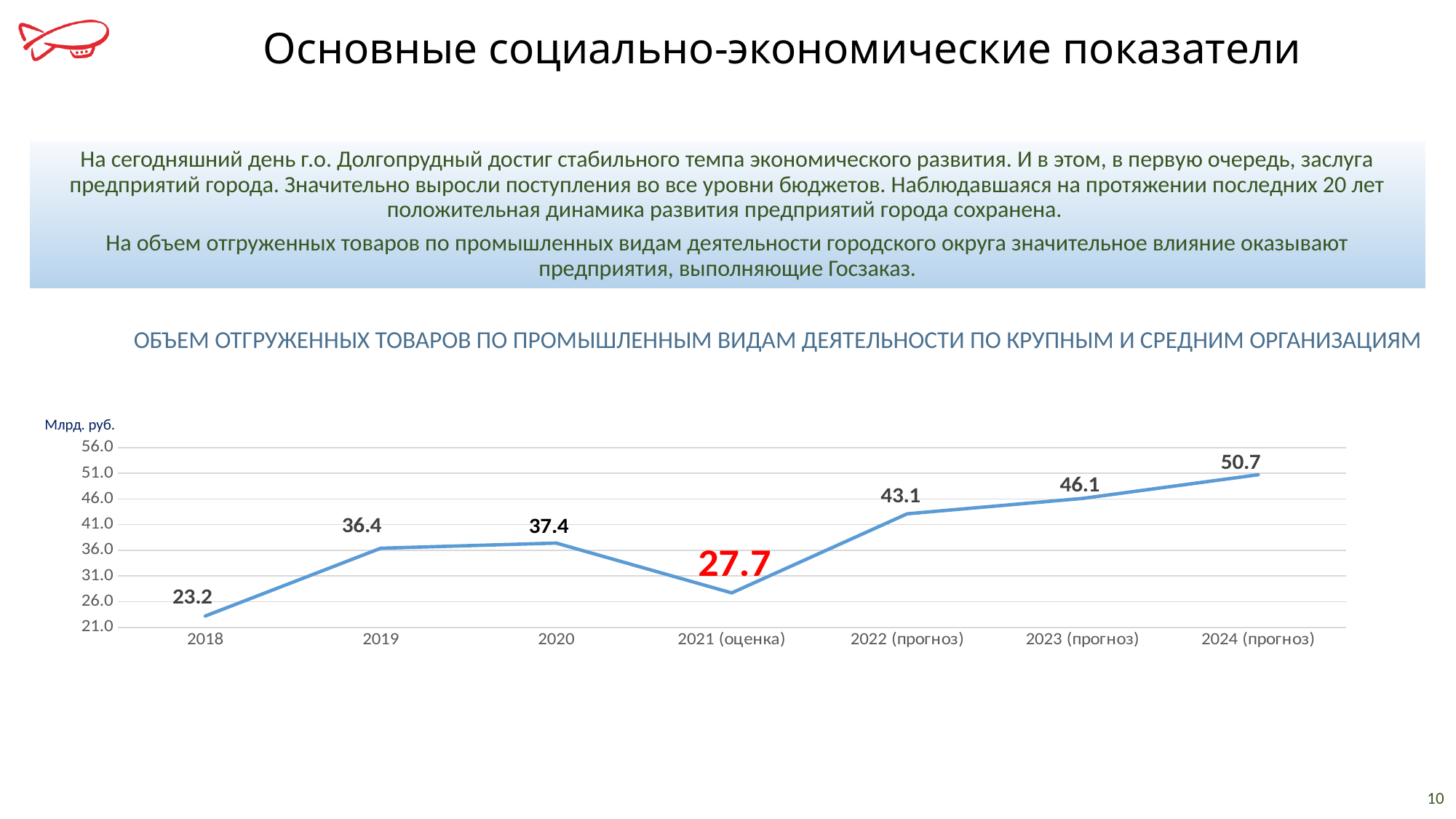
What unit is shown on the chart's vertical axis? Млрд. руб. What kind of chart is shown on the slide? line chart What is the difference between the values for 2020 and 2019? 1.0 What is the value for 2018? 23.2 Which year has the lowest value? 2018 Which is larger, the value for 2020 or the value for 2021 (оценка)? 2020 What is the value for 2021 (оценка)? 27.7 Which year has the highest value? 2024 (прогноз) How many data points are plotted on the chart? 7 Do the values rise or fall from 2021 (оценка) to 2024 (прогноз)? rise What is the value for 2024 (прогноз)? 50.7 What is the difference between the values for 2022 (прогноз) and 2021 (оценка)? 15.4